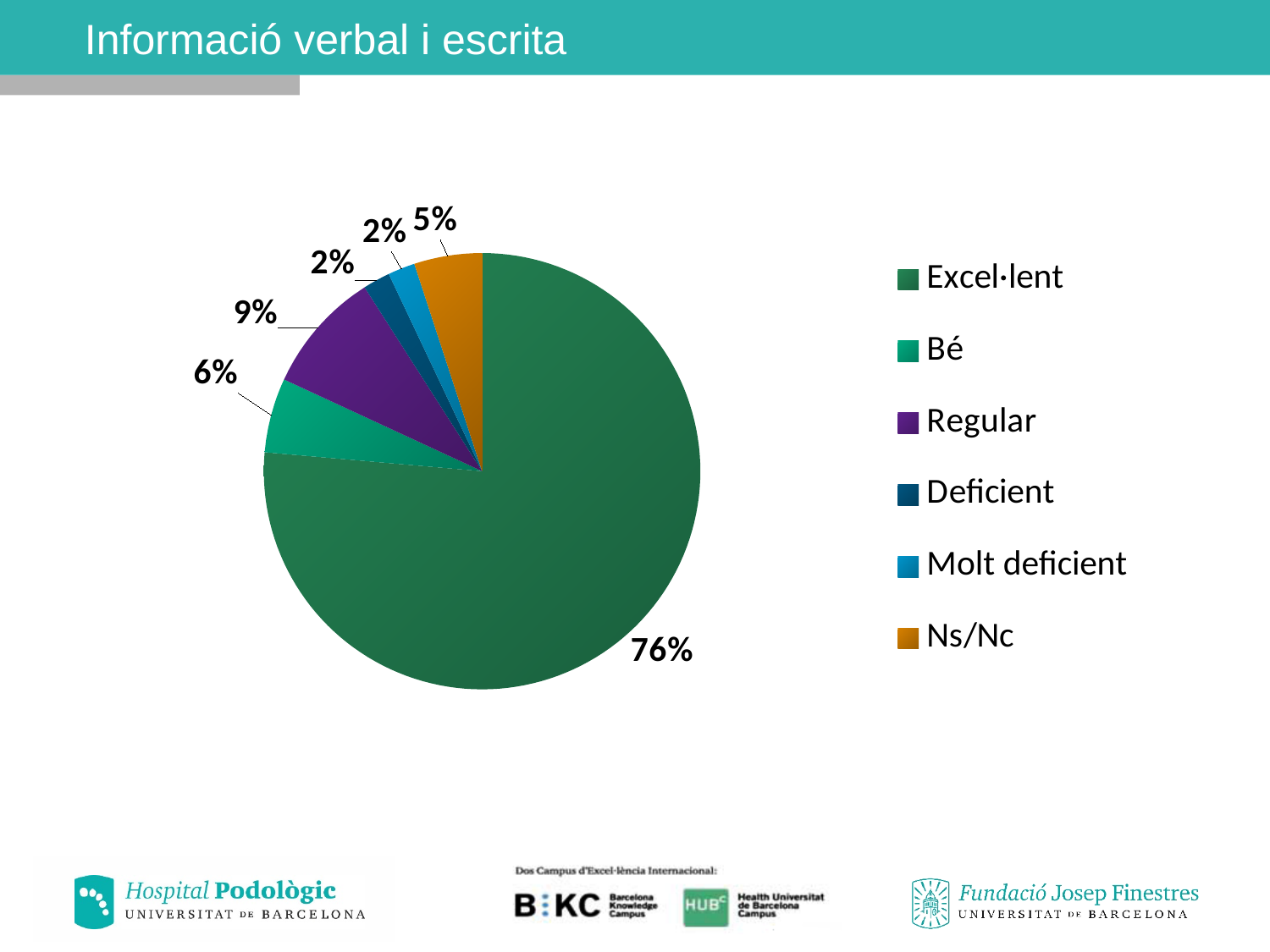
What percentage of the pie is labelled Bé? 6% What is the difference in percentage points between the Excel·lent share and the Regular share? 67 What percentage of the pie is labelled Excel·lent? 76% What percentage of the pie is labelled Regular? 9% What is the title of the slide containing the chart? Informació verbal i escrita How many categories does the legend list? 6 What percentage of the pie is labelled Ns/Nc? 5% What percentage of the pie is labelled Deficient? 2% What kind of chart is shown on the slide? Pie chart Which legend entry is shown in orange? Ns/Nc Which category has the largest share of the pie? Excel·lent Which is larger, the share for Regular or the share for Bé? Regular